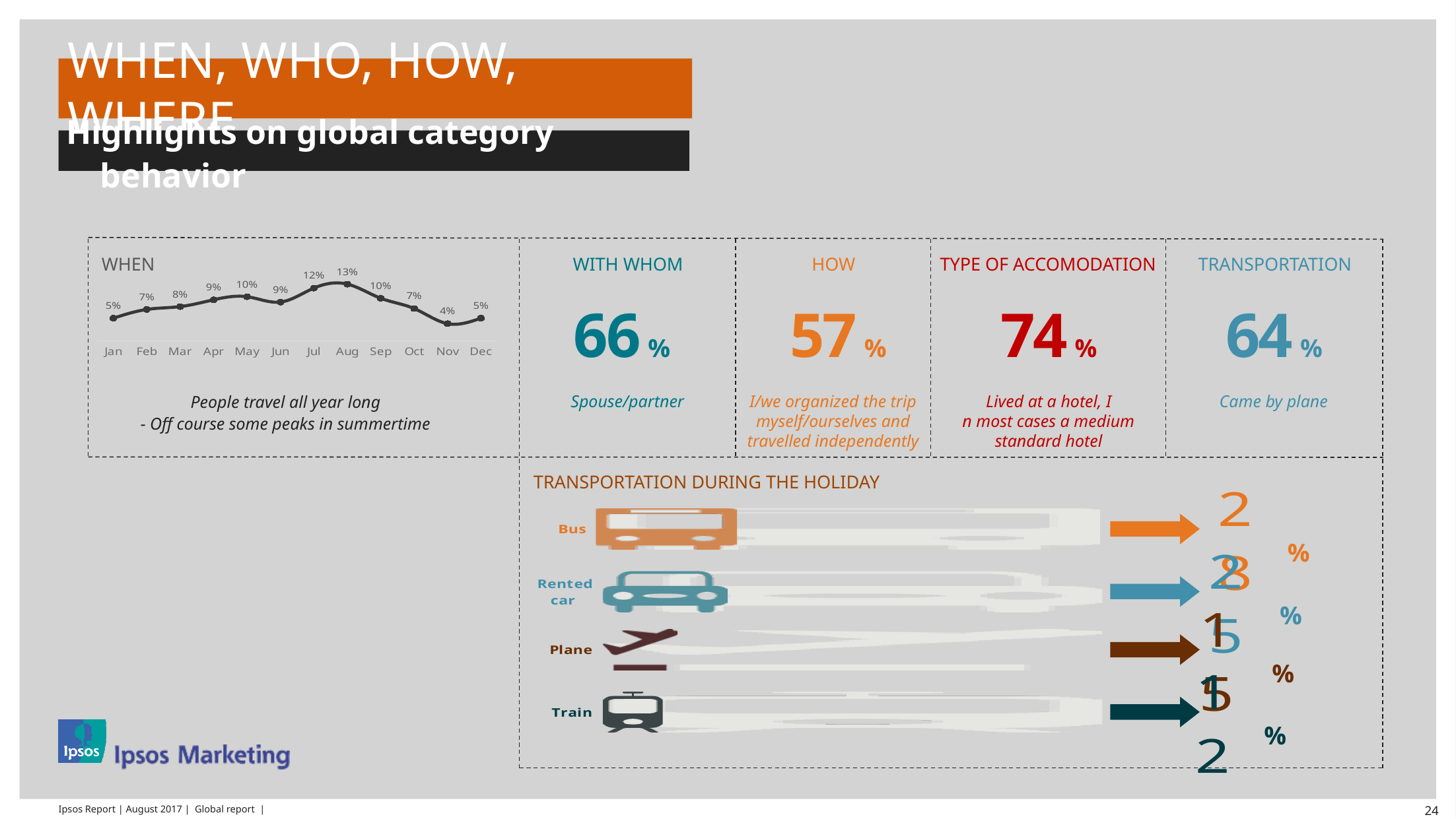
How many months are plotted in the WHEN chart? 12 In the WHEN chart, do the values rise or fall from Aug to Nov? fall In the WHEN chart, which month has the highest value? Aug In the WHEN chart, which is larger, the value for May or the value for Oct? May In the WHEN chart, what is the difference between the values for Jul and Jun? 3% How many transport categories are listed in the TRANSPORTATION DURING THE HOLIDAY chart? 4 In the WHEN chart, which month has the lowest value? Nov In the WHEN chart, what is the value for Aug? 13% In the WHEN chart, what is the difference between the values for Aug and Nov? 9% In the WHEN chart, what is the value for Nov? 4% In the WHEN chart, what is the value for Jan? 5% What kind of chart is the WHEN chart? line chart